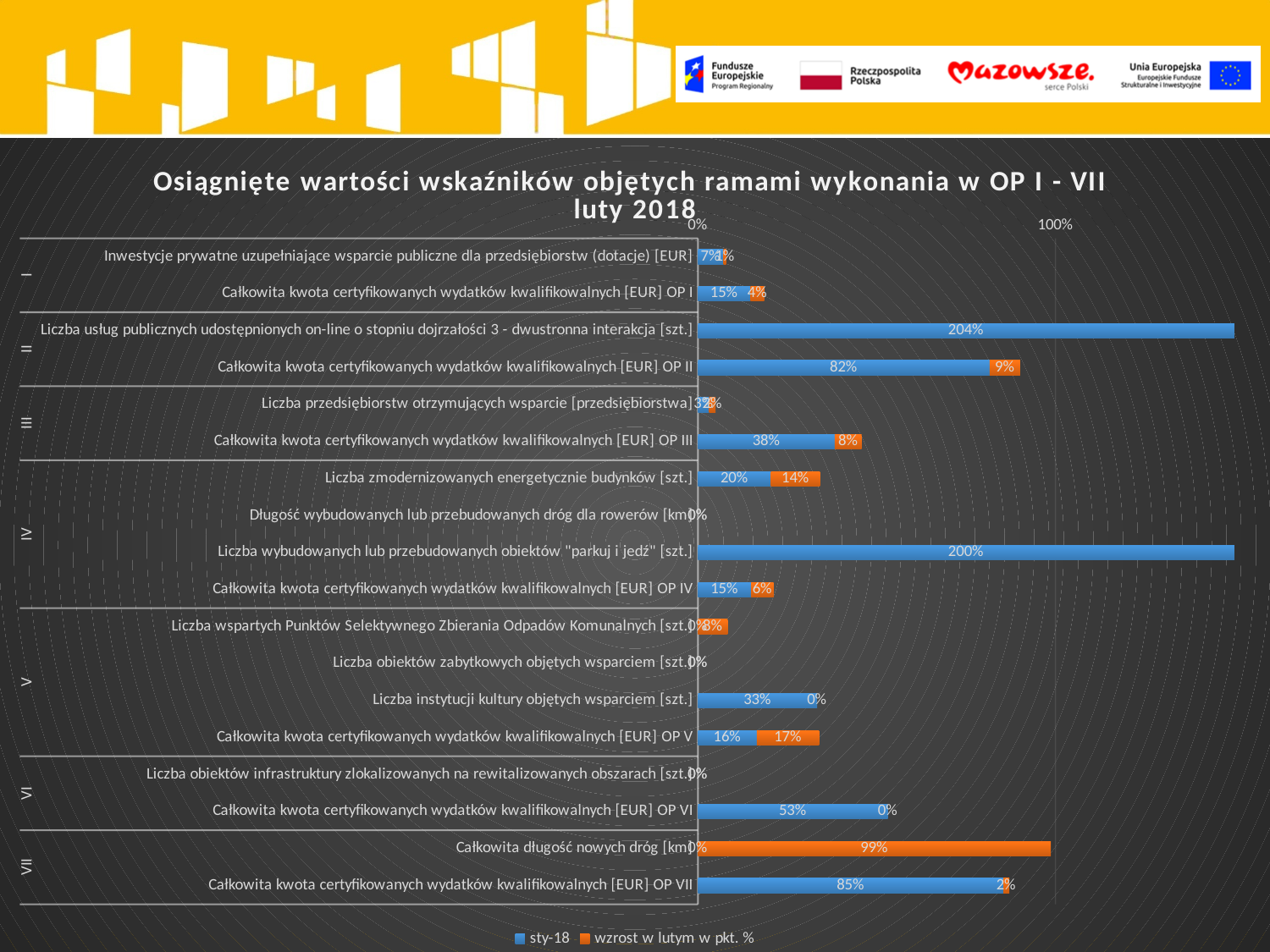
How many categories are plotted on the chart? 18 What is the total of the stacked bar for "Całkowita kwota certyfikowanych wydatków kwalifikowalnych [EUR] OP V"? 33% What kind of chart is shown on the slide? bar chart What is the difference between the sty-18 values for "Całkowita kwota certyfikowanych wydatków kwalifikowalnych [EUR] OP VII" and "Całkowita kwota certyfikowanych wydatków kwalifikowalnych [EUR] OP VI"? 32% What is the sty-18 value for "Liczba wybudowanych lub przebudowanych obiektów "parkuj i jedź" [szt.]"? 200% What is the sty-18 value for "Całkowita kwota certyfikowanych wydatków kwalifikowalnych [EUR] OP II"? 82% How many series does the legend list? 2 What is the "wzrost w lutym w pkt. %" value for "Całkowita długość nowych dróg [km]"? 99% Which series is shown in orange according to the legend? wzrost w lutym w pkt. % Which has a larger sty-18 value: "Całkowita kwota certyfikowanych wydatków kwalifikowalnych [EUR] OP III" or "Liczba instytucji kultury objętych wsparciem [szt.]"? Całkowita kwota certyfikowanych wydatków kwalifikowalnych [EUR] OP III Which category has the highest sty-18 value? Liczba usług publicznych udostępnionych on-line o stopniu dojrzałości 3 - dwustronna interakcja [szt.] What is the "wzrost w lutym w pkt. %" value for "Liczba zmodernizowanych energetycznie budynków [szt.]"? 14%